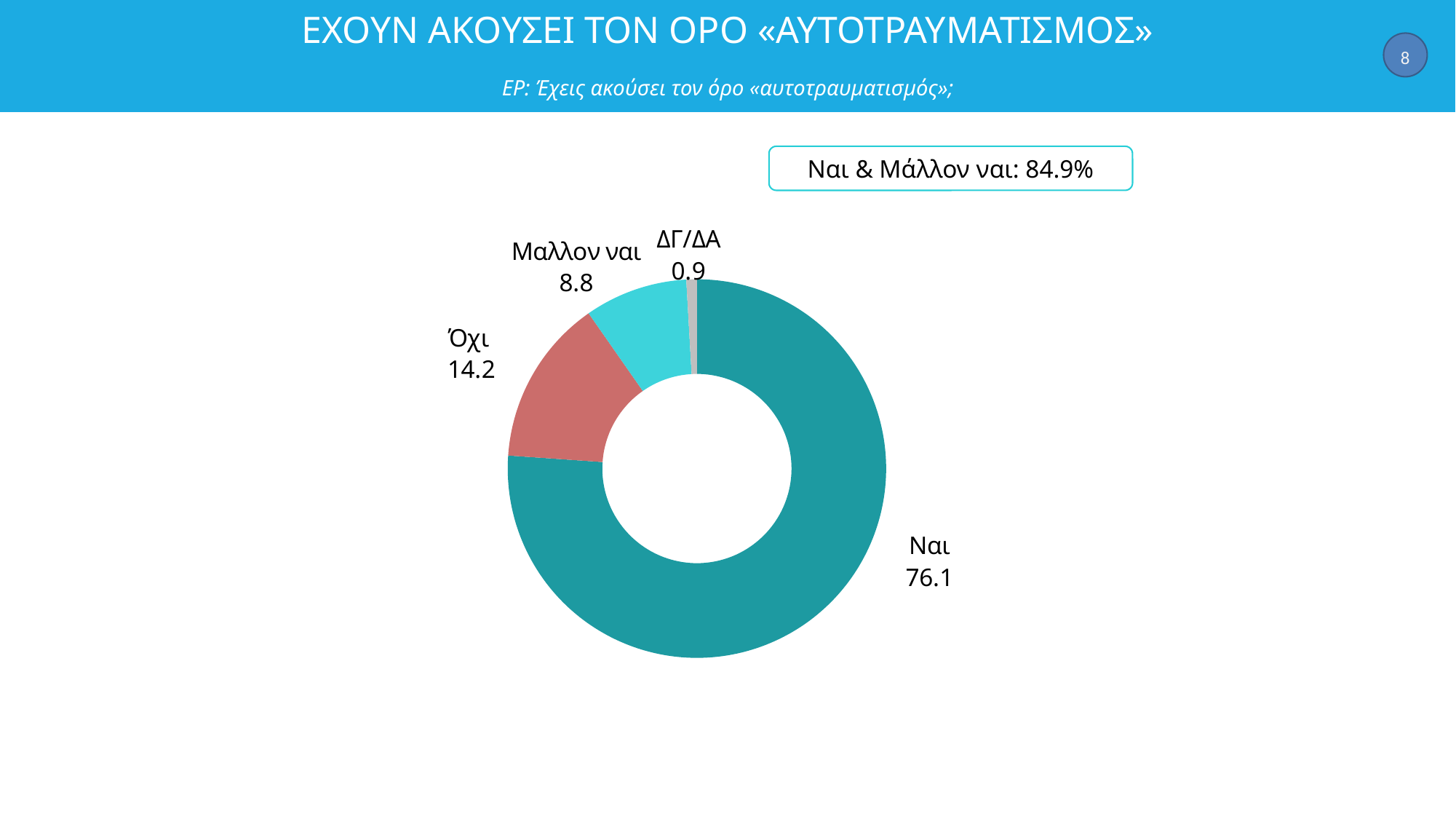
What value is shown for the Ναι slice? 76.1 How many slices does the chart have? 4 What value is shown for the Όχι slice? 14.2 Which category has the largest slice? Ναι What value is shown for the Μαλλον ναι slice? 8.8 Which is larger, the Όχι value or the Μαλλον ναι value? Όχι What value is shown for the ΔΓ/ΔΑ slice? 0.9 Which category has the smallest slice? ΔΓ/ΔΑ What colour is the Όχι slice? Red What kind of chart is shown on the slide? Doughnut (pie) chart What combined value does the box above the chart give for Ναι & Μάλλον ναι? 84.9% What is the difference between the Ναι value and the Όχι value? 61.9